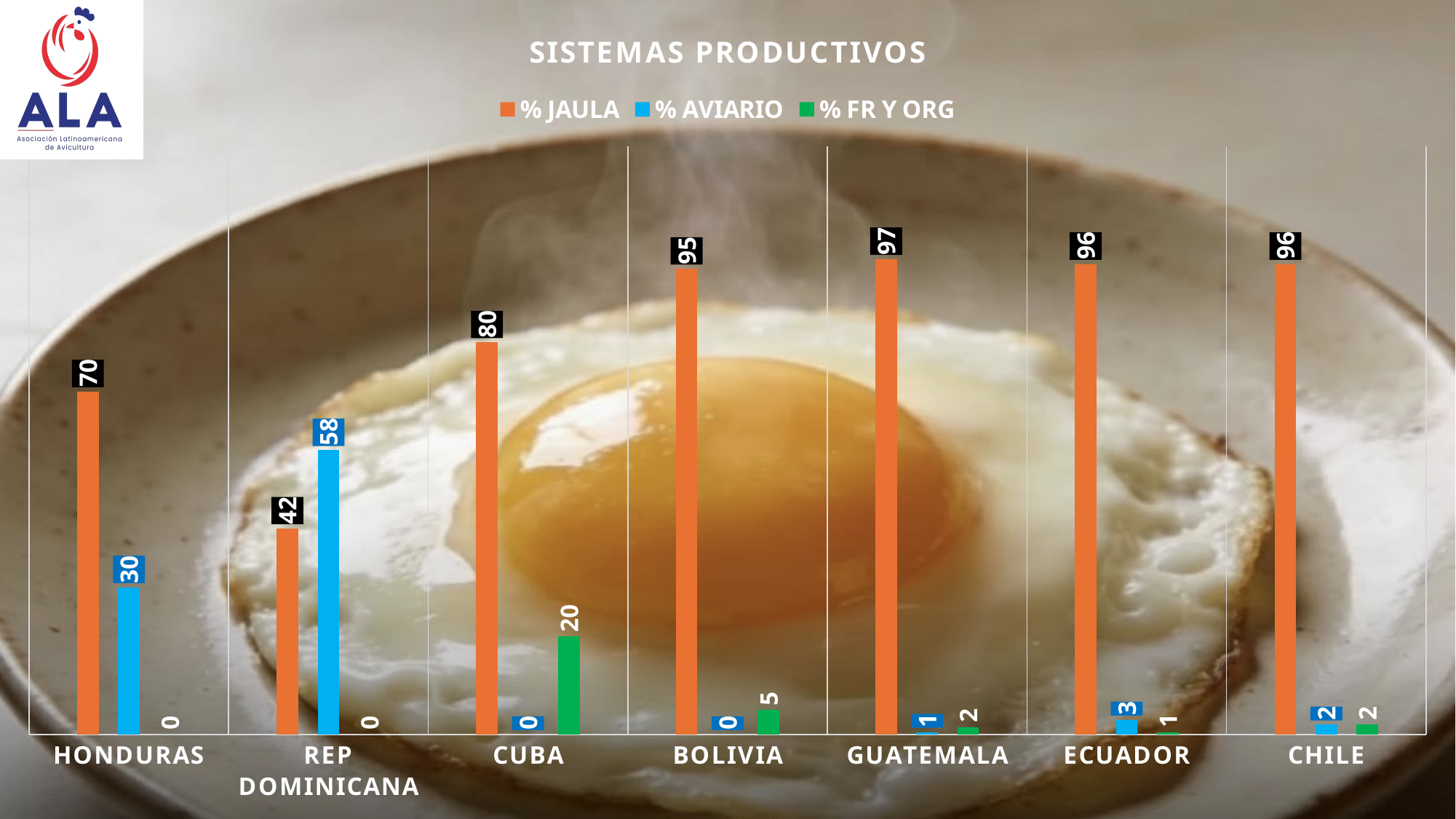
Which is larger for Rep Dominicana, % JAULA or % AVIARIO? % AVIARIO What kind of chart is shown on the slide? Bar chart What is the title of the chart? SISTEMAS PRODUCTIVOS Which country has the highest % JAULA value? Guatemala What is the difference between the % JAULA values for Bolivia and Cuba? 15 How many countries are shown on the x axis? 7 What is the % FR Y ORG value for Cuba? 20 What is the % JAULA value for Honduras? 70 What is the % AVIARIO value for Ecuador? 3 Which country has the lowest % JAULA value? Rep Dominicana What is the % AVIARIO value for Rep Dominicana? 58 How many series does the legend list? 3